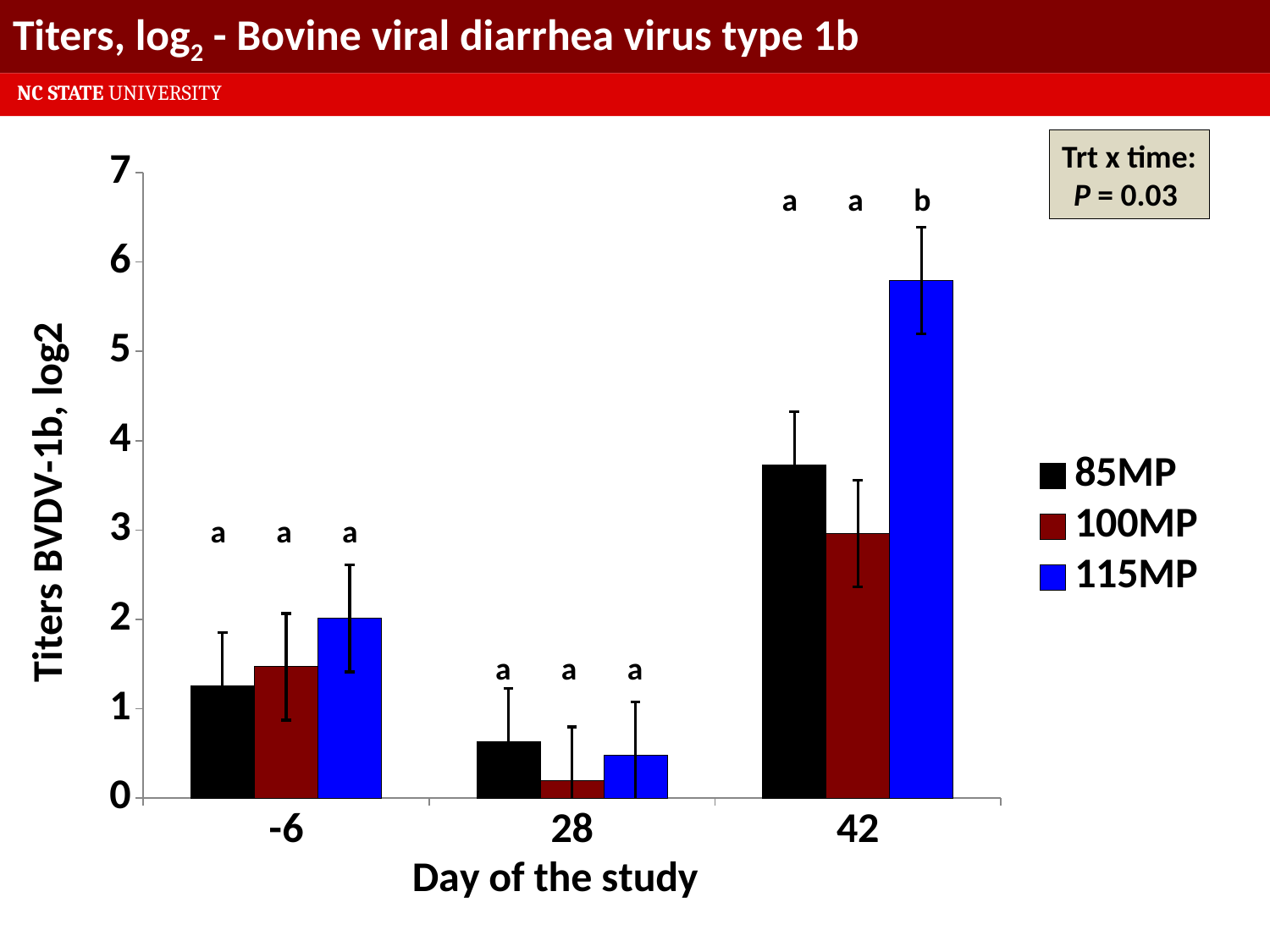
Is the titer for 85MP on day 42 greater or less than 4? less How many series does the legend list? 3 What P value is shown for the treatment x time interaction? P = 0.03 On day 42, which is larger: the titer for 85MP or for 115MP? 115MP On day -6, which is larger: the titer for 85MP or for 115MP? 115MP How many day-of-study categories are shown on the x axis? 3 Which treatment has the highest titer on day 42? 115MP Is the titer for 115MP on day 42 greater or less than 5? greater Which treatment has the lowest titer on day 28? 100MP Is the titer for 100MP on day 28 greater or less than 1? less What kind of chart is shown on the slide? bar chart For the 115MP treatment, do titers rise or fall from day 28 to day 42? rise